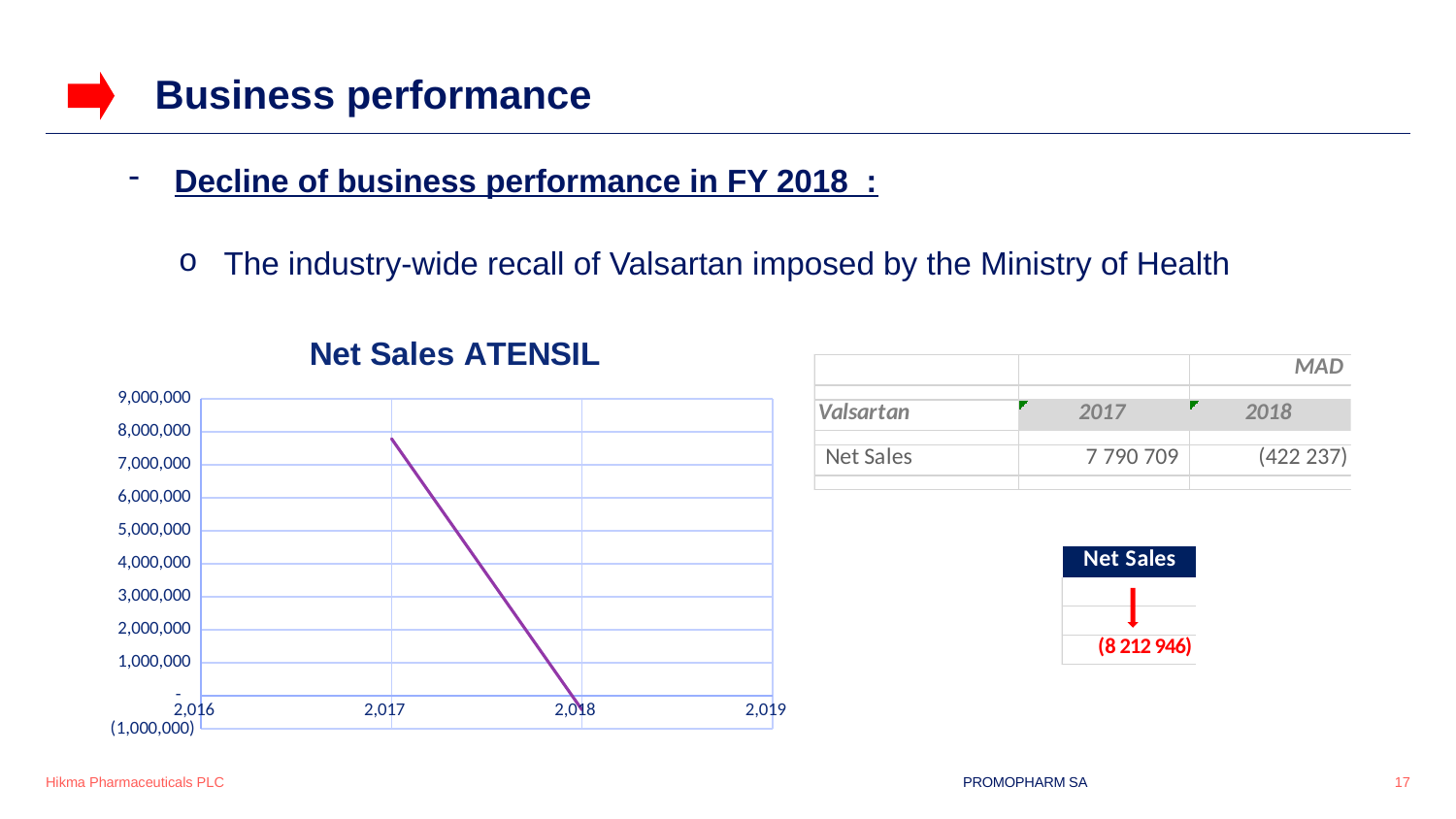
In the Net Sales ATENSIL chart, which year shows the highest plotted value? 2017 What type of chart is shown under the title "Net Sales ATENSIL"? Line chart In the Net Sales ATENSIL chart, which year has the higher value, 2017 or 2018? 2017 In the Net Sales ATENSIL chart, is the value for 2018 greater or less than 1,000,000? less What is the highest value labelled on the y axis of the Net Sales ATENSIL chart? 9,000,000 How many year labels are shown on the x axis of the Net Sales ATENSIL chart? 4 In the Net Sales ATENSIL chart, is the value for 2017 greater or less than 8,000,000? less In the Net Sales ATENSIL chart, is the value for 2018 greater or less than 2,000,000? less In the Net Sales ATENSIL chart, does the line rise or fall from 2017 to 2018? Fall What is the title of the chart on the slide? Net Sales ATENSIL In the Net Sales ATENSIL chart, which year shows the lowest plotted value? 2018